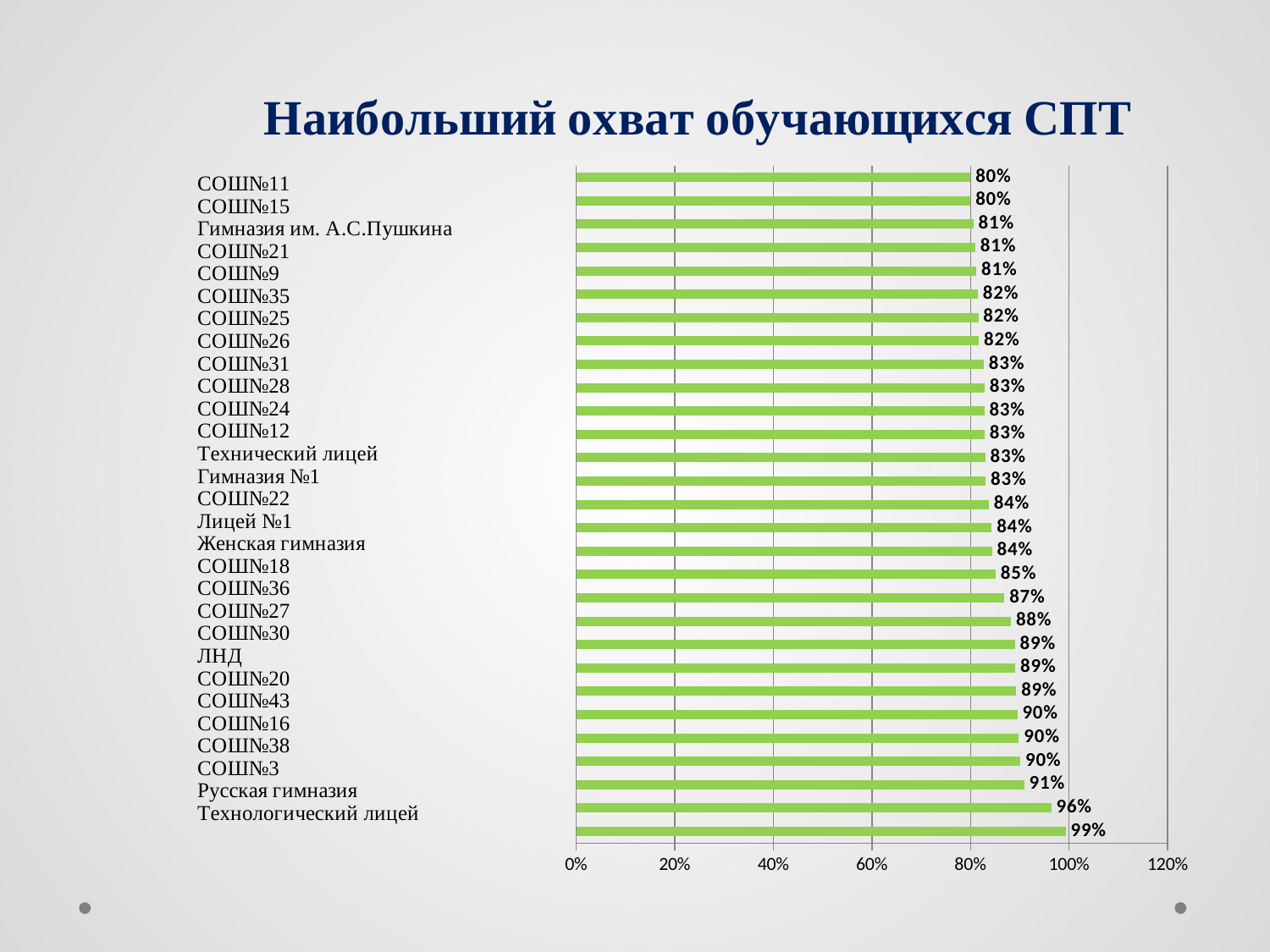
What is the value for СОШ№36? 87% What is the value for Технологический лицей? 99% What is the value for СОШ№18? 85% What is the value for Русская гимназия? 96% Which has a larger value, СОШ№3 or СОШ№27? СОШ№3 Which category has the highest value? Технологический лицей What is the difference between the values for Технологический лицей and Русская гимназия? 3% What is the lowest value shown on the chart? 80% What is the title of the chart on the slide? Наибольший охват обучающихся СПТ What is the difference between the values for СОШ№3 and СОШ№11? 11% What type of chart is shown on the slide? bar chart How many categories are shown on the chart? 29